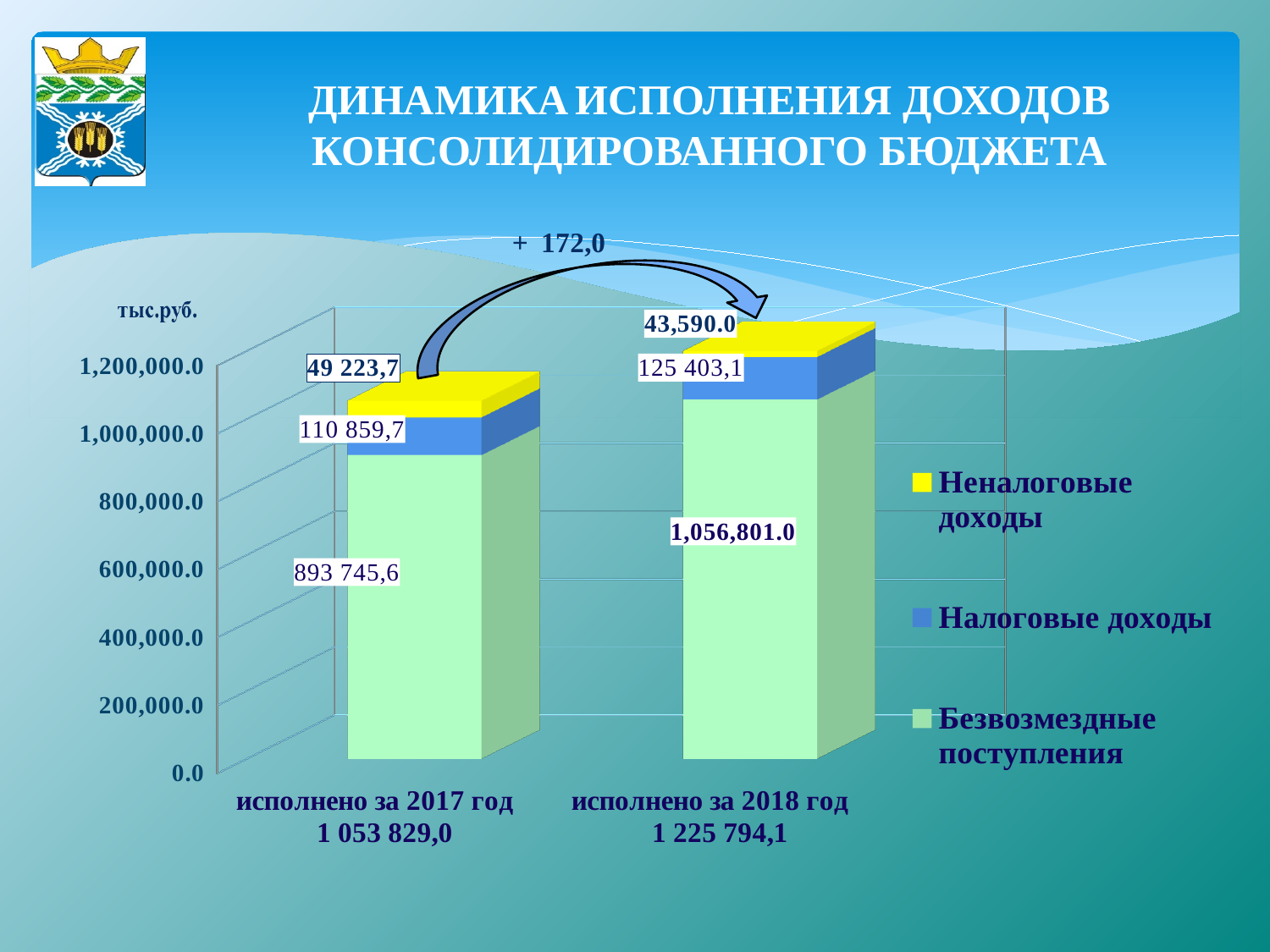
How many series does the legend list? 3 What is the total of the stacked bar for исполнено за 2017 год? 1 053 829,0 Which year has the larger value for Неналоговые доходы, 2017 or 2018? 2017 What kind of chart is shown on the slide? stacked bar chart What is the value of Налоговые доходы for исполнено за 2017 год? 110 859,7 What is the value of Неналоговые доходы for исполнено за 2017 год? 49 223,7 What is the value of Неналоговые доходы for исполнено за 2018 год? 43,590.0 What is the total of the stacked bar for исполнено за 2018 год? 1 225 794,1 What is the difference between Налоговые доходы in 2018 and in 2017? 14 543,4 What is the value of Безвозмездные поступления for исполнено за 2018 год? 1,056,801.0 How many categories are shown on the x axis? 2 Is the total for исполнено за 2017 год greater or less than 1,000,000.0? greater